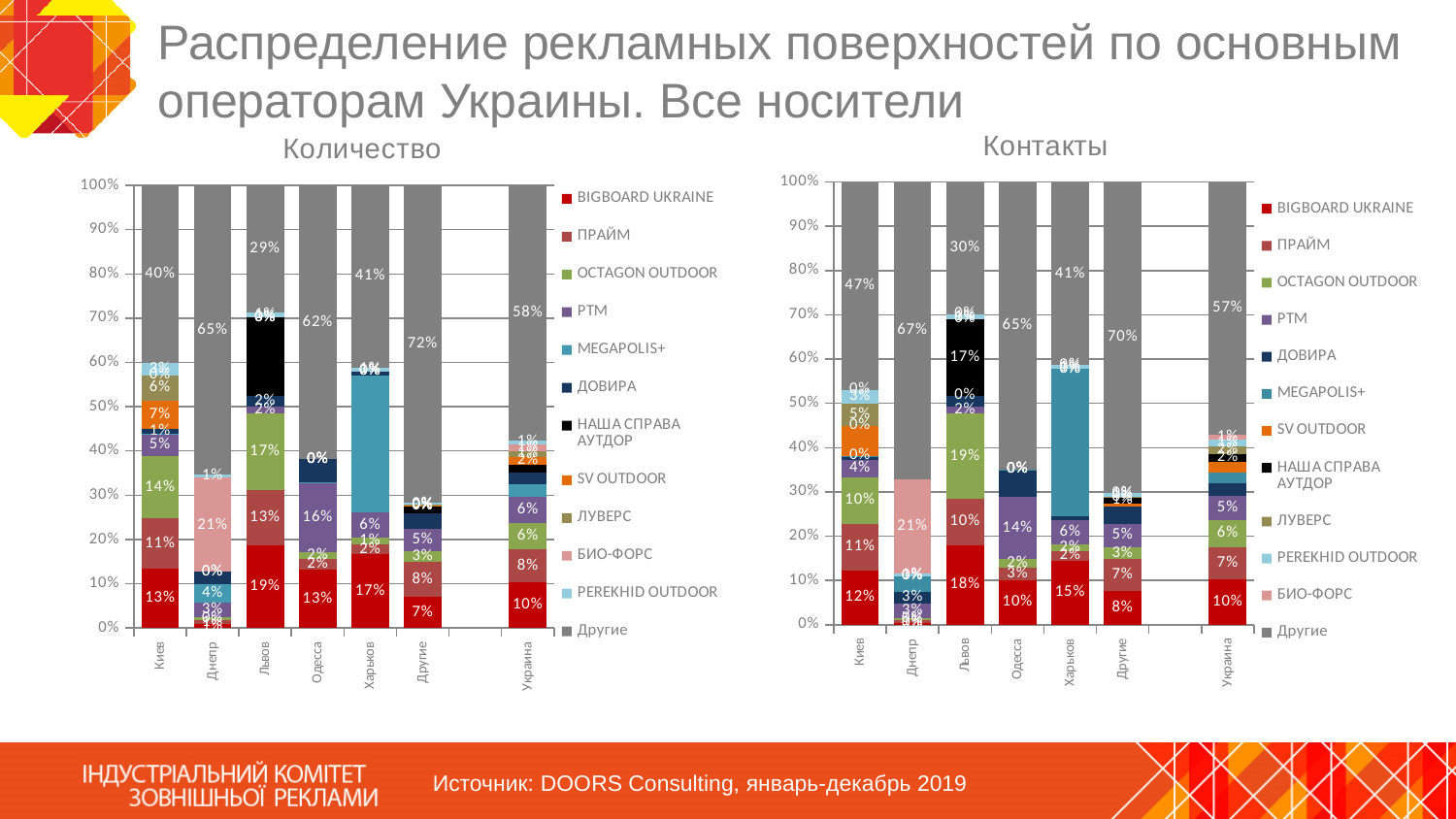
On the Контакты chart, what share does Другие (the gray segment) hold for Львов? 30% On the Количество chart, what is the difference between the Другие share for Днепр and for Львов? 36% On the Контакты chart, which category has the smallest Другие (gray) share? Львов On the Контакты chart, which is larger: the BIGBOARD UKRAINE share for Киев or for Одесса? Киев On the Количество chart, what share does Другие (the gray segment) hold for Киев? 40% How many categories are shown on the x axis of the Количество chart? 7 On the Количество chart, what is the BIGBOARD UKRAINE share for Львов? 19% On the Контакты chart, what is the BIGBOARD UKRAINE share for Харьков? 15% On the Контакты chart, what is the Другие (gray) share for Украина? 57% How many series does the legend of the Контакты chart list? 12 On the Количество chart, which category has the largest Другие (gray) share? Другие What type of chart is the Количество chart? Stacked bar chart